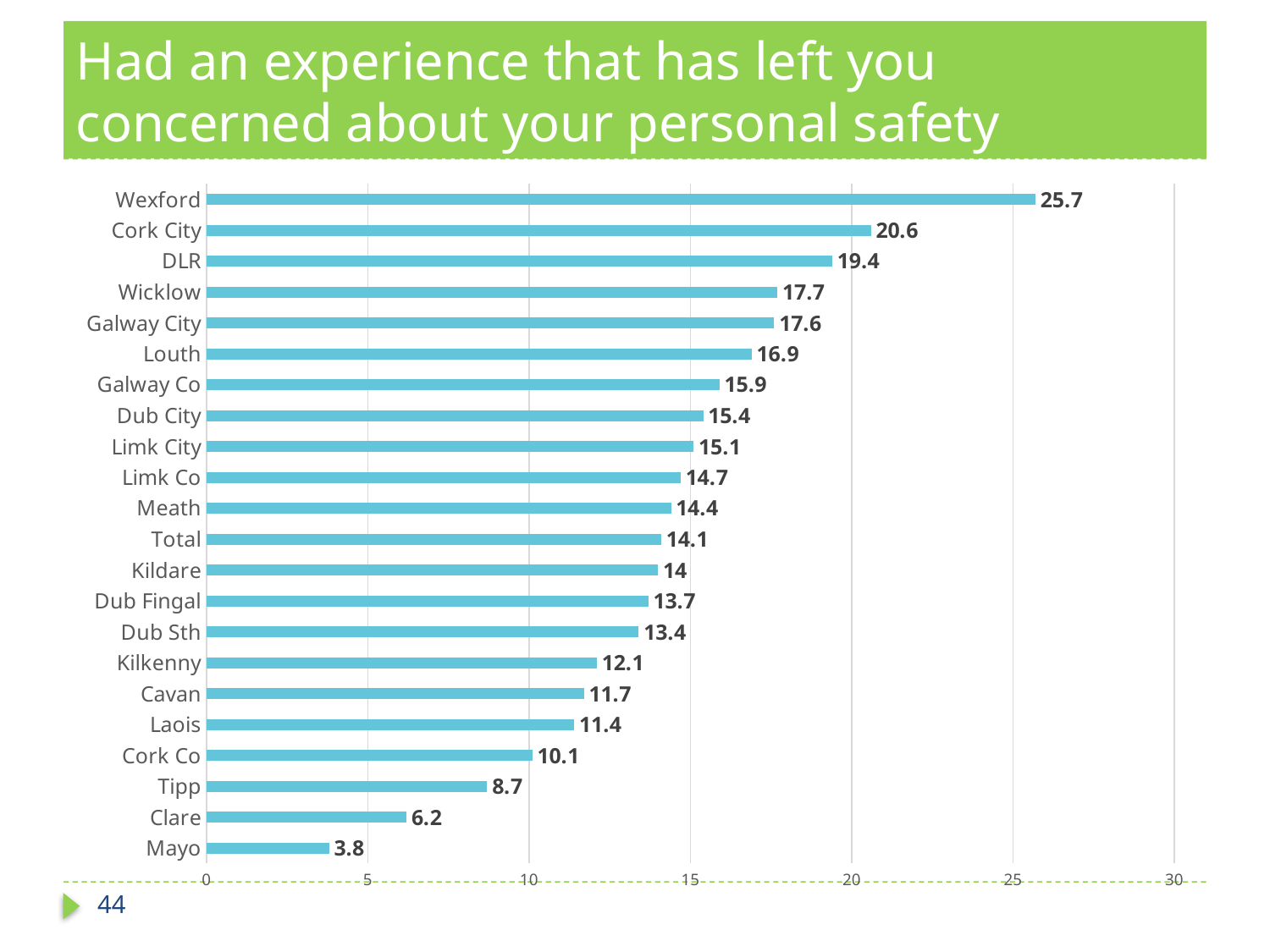
What is the difference between the values for Cork City and DLR? 1.2 What is the value for Galway City? 17.6 What is the difference between the values for Wexford and Mayo? 21.9 What is the value for Wexford? 25.7 Is the value for Tipp greater or less than 10? less Which category has the highest value? Wexford What is the value for Total? 14.1 Which category has the lowest value? Mayo What kind of chart is shown on the slide? bar chart What is the value for Cork Co? 10.1 Which is larger, the value for Louth or the value for Kildare? Louth How many categories are shown on the chart? 22